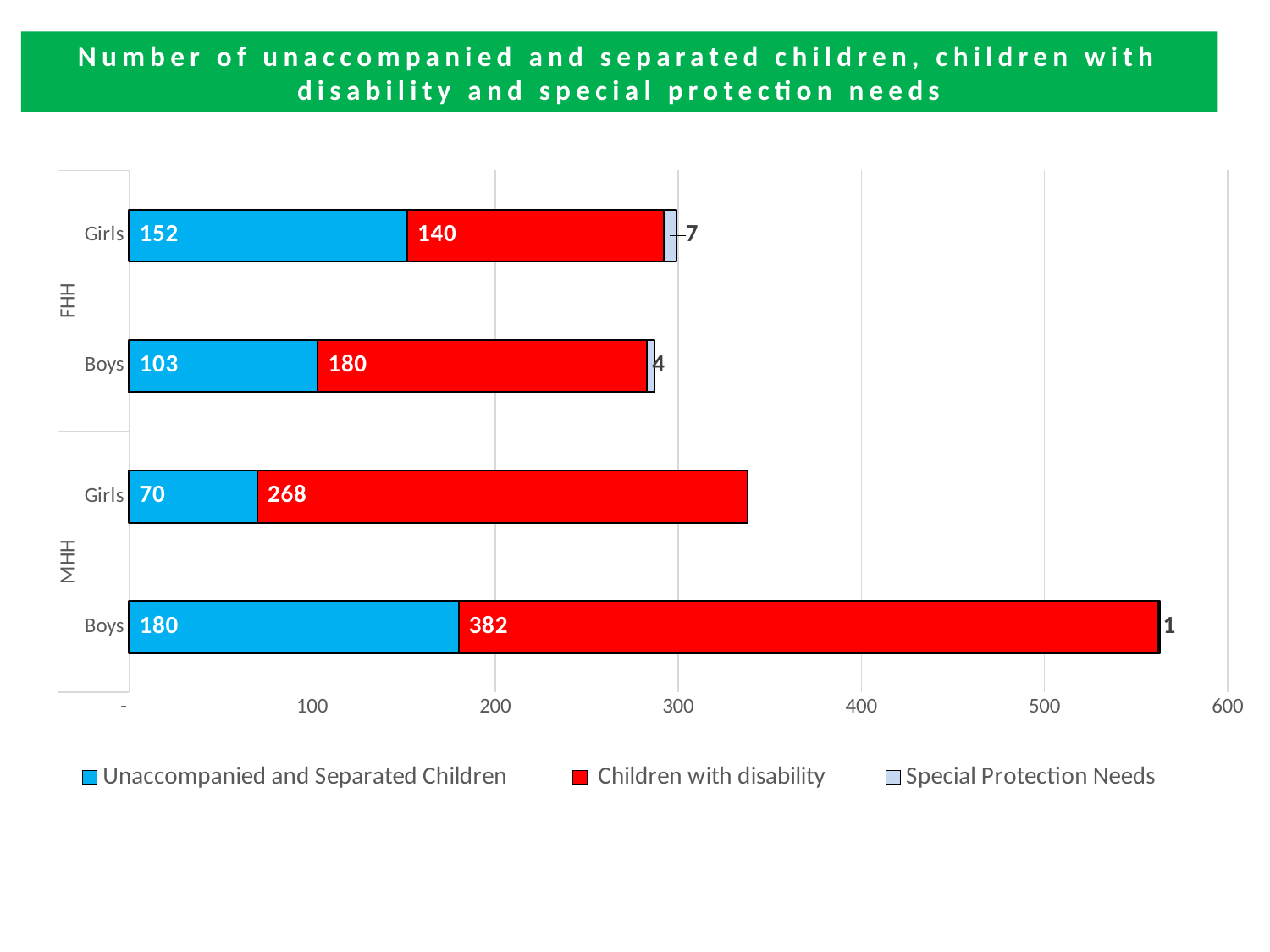
What is the value for Children with disability for MHH Girls? 268 How many series does the legend list? 3 What is the total of the stacked bar for FHH Boys? 287 What is the difference between the Children with disability values for MHH Boys and MHH Girls? 114 Is the total of the stacked bar for MHH Boys greater or less than 500? greater What is the value for Special Protection Needs for FHH Girls? 7 What is the value for Unaccompanied and Separated Children for FHH Girls? 152 What type of chart is shown on the slide? stacked bar chart Which category has the lowest value for Unaccompanied and Separated Children? MHH Girls Which category has the highest value for Children with disability? MHH Boys What is the value for Children with disability for MHH Boys? 382 Which is larger: the Unaccompanied and Separated Children value for FHH Girls or for FHH Boys? FHH Girls